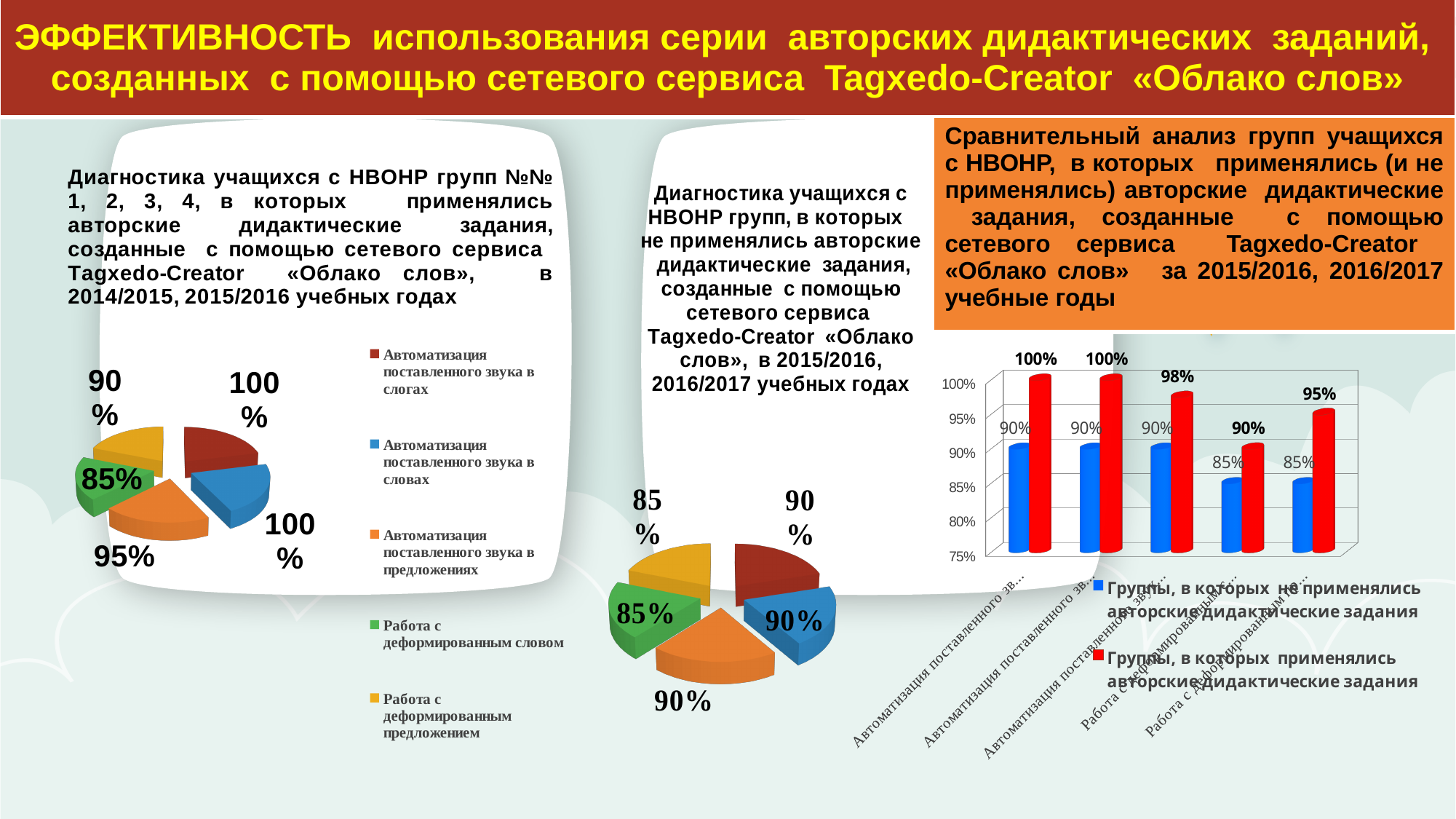
How many categories are shown on the x axis of the right bar chart? 5 In the left pie chart, what is the value for «Автоматизация поставленного звука в предложениях»? 95% How many slices does the middle pie chart have? 5 How many series does the legend of the right bar chart list? 2 In the left pie chart, what is the value for «Работа с деформированным словом»? 85% In the right bar chart, what is the value of the red series (Группы, в которых применялись авторские дидактические задания) for the third category? 98% How many entries does the legend of the left pie chart list? 5 What kind of chart is the chart on the right of the slide (Сравнительный анализ групп учащихся)? Bar chart In the left pie chart, which category has the lowest value? Работа с деформированным словом What kind of chart is the left chart (Диагностика учащихся с НВОНР групп №№ 1, 2, 3, 4)? Pie chart In the right bar chart, what is the difference between the red and blue bars in the fifth (last) category? 10 percentage points In the right bar chart, which series has the larger value in the fourth category: the blue series or the red series? The red series (Группы, в которых применялись авторские дидактические задания)